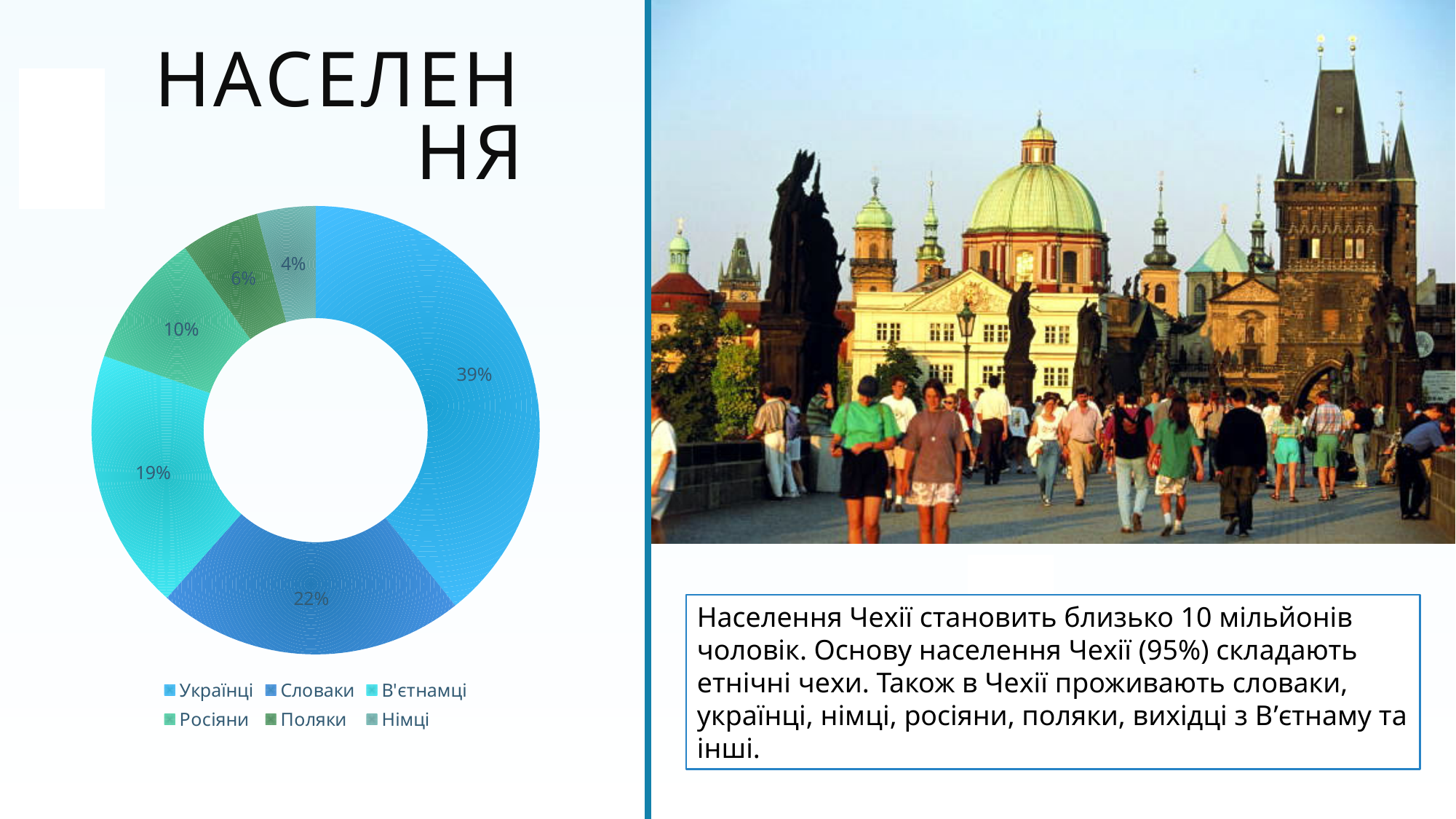
What percentage is shown for Словаки? 22% What share of the doughnut chart does Українці account for? 39% Which has a larger share, Словаки or В'єтнамці? Словаки Which category has the smallest share of the chart? Німці What kind of chart is shown on the slide? Doughnut (pie) chart Which category has the largest share of the chart? Українці What percentage is shown for В'єтнамці? 19% What is the difference in percentage points between Росіяни and Поляки? 4 What percentage is shown for Німці? 4% What is the title of the slide containing the chart? НАСЕЛЕННЯ What is the difference in percentage points between Українці and Словаки? 17 How many categories does the chart show? 6